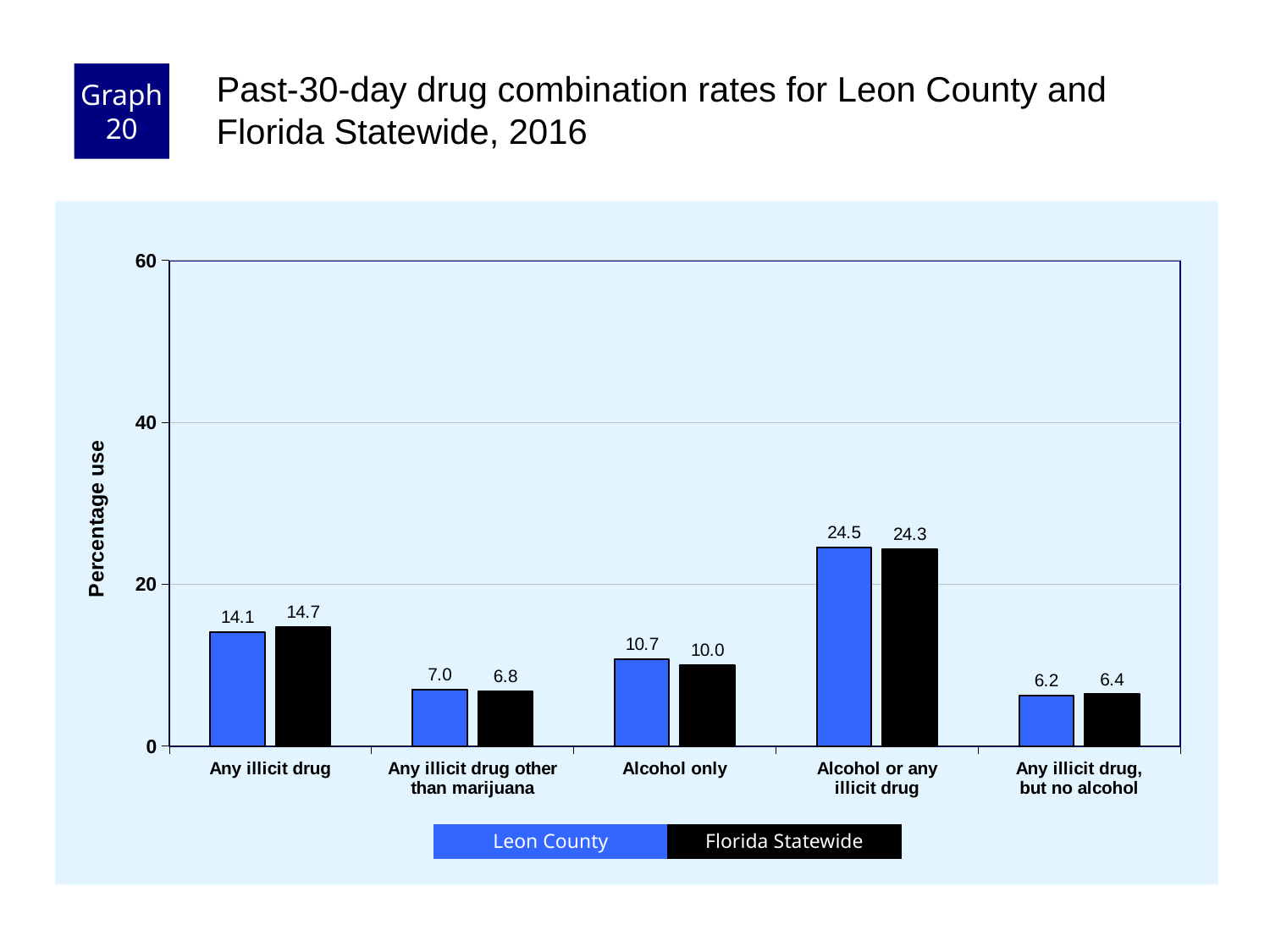
What is the Florida Statewide value for Alcohol only? 10.0 Which is larger for Alcohol only: Leon County or Florida Statewide? Leon County Which category has the lowest Florida Statewide value? Any illicit drug, but no alcohol How many categories are shown on the x axis? 5 Is the Leon County value for Alcohol or any illicit drug greater or less than 20? greater Which category has the highest Leon County value? Alcohol or any illicit drug What is the difference between the Florida Statewide and Leon County values for Any illicit drug? 0.6 What is the Leon County value for Any illicit drug, but no alcohol? 6.2 How many series does the legend list? 2 What is the label of the y axis? Percentage use What kind of chart is shown? bar chart What is the Leon County value for Any illicit drug? 14.1